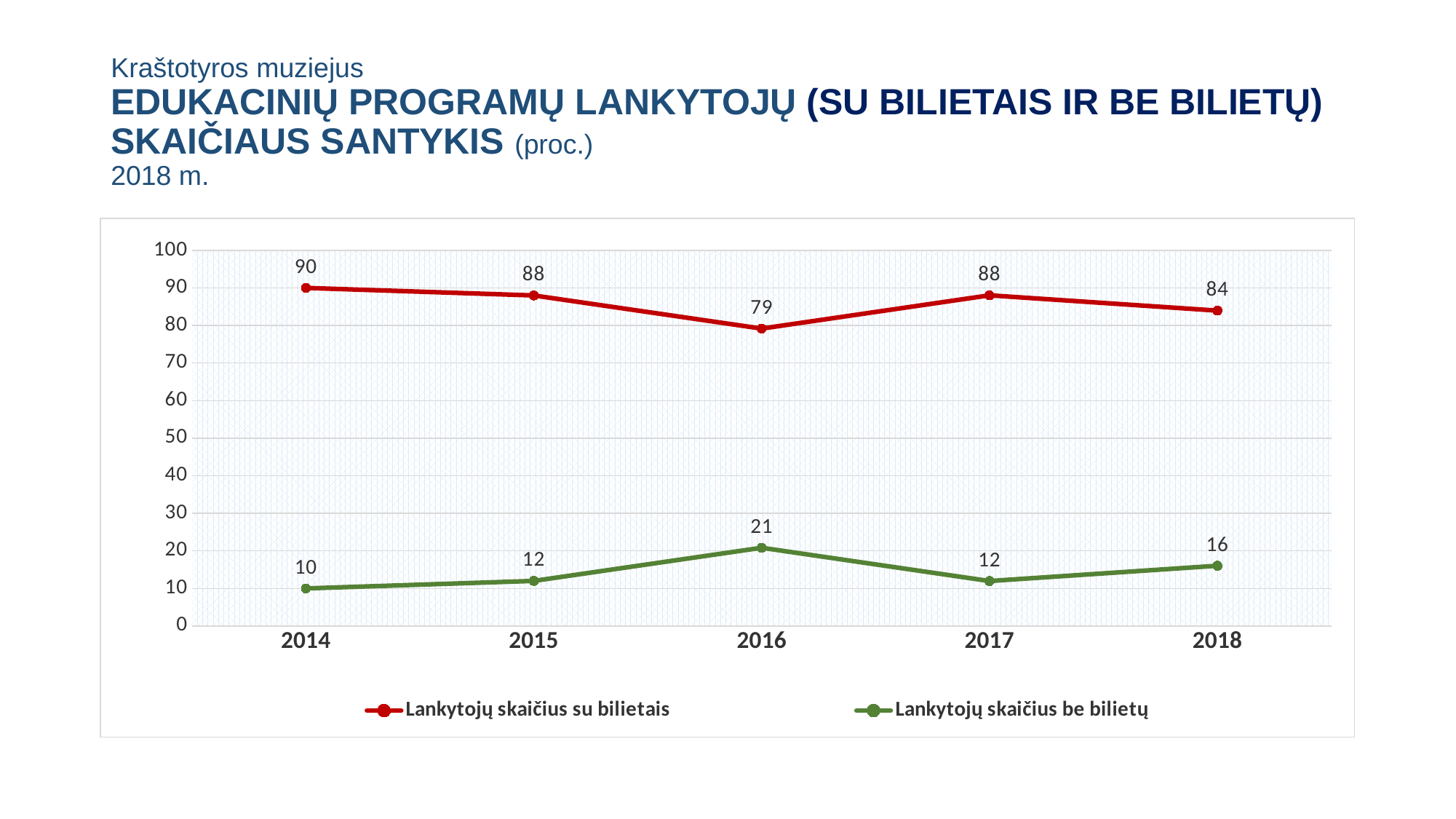
What is the value for 'Lankytojų skaičius su bilietais' in 2016? 79 How many years are shown on the x axis? 5 In which year is 'Lankytojų skaičius su bilietais' lowest? 2016 What is the difference between 'Lankytojų skaičius su bilietais' and 'Lankytojų skaičius be bilietų' in 2018? 68 What colour is the line for 'Lankytojų skaičius be bilietų'? green In which year is 'Lankytojų skaičius be bilietų' highest? 2016 What is the value for 'Lankytojų skaičius su bilietais' in 2014? 90 What kind of chart is shown on the slide? line chart How many series does the legend list? 2 What is the value for 'Lankytojų skaičius be bilietų' in 2018? 16 Is the value for 'Lankytojų skaičius su bilietais' in 2017 greater or less than 80? greater Which is larger: 'Lankytojų skaičius be bilietų' in 2016 or in 2017? 2016